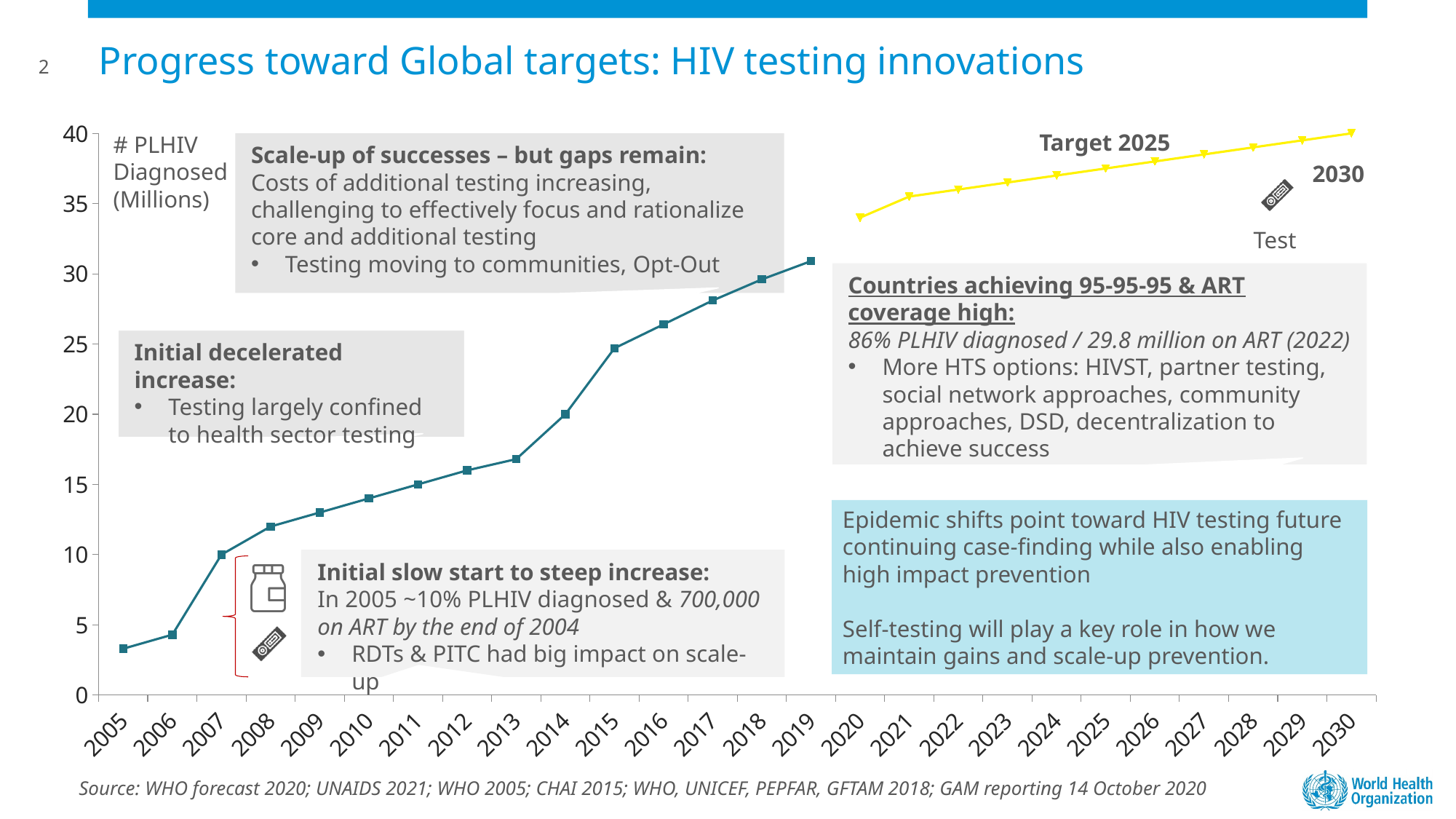
Is the value for 2016 greater or less than 25? greater What is the label on the vertical axis of the chart? # PLHIV Diagnosed (Millions) Do the plotted values rise or fall from 2005 to 2030? rise Is the value for 2005 greater or less than 5? less Which year has the larger plotted value, 2010 or 2019? 2019 What colour is the line showing the target values from 2020 to 2030? yellow Which year has the lowest plotted value on the chart? 2005 Is the value for 2020 greater or less than 35? less How many years are labelled along the x axis of the chart? 26 What kind of chart is shown on the slide? line chart Which year has the highest plotted value on the chart? 2030